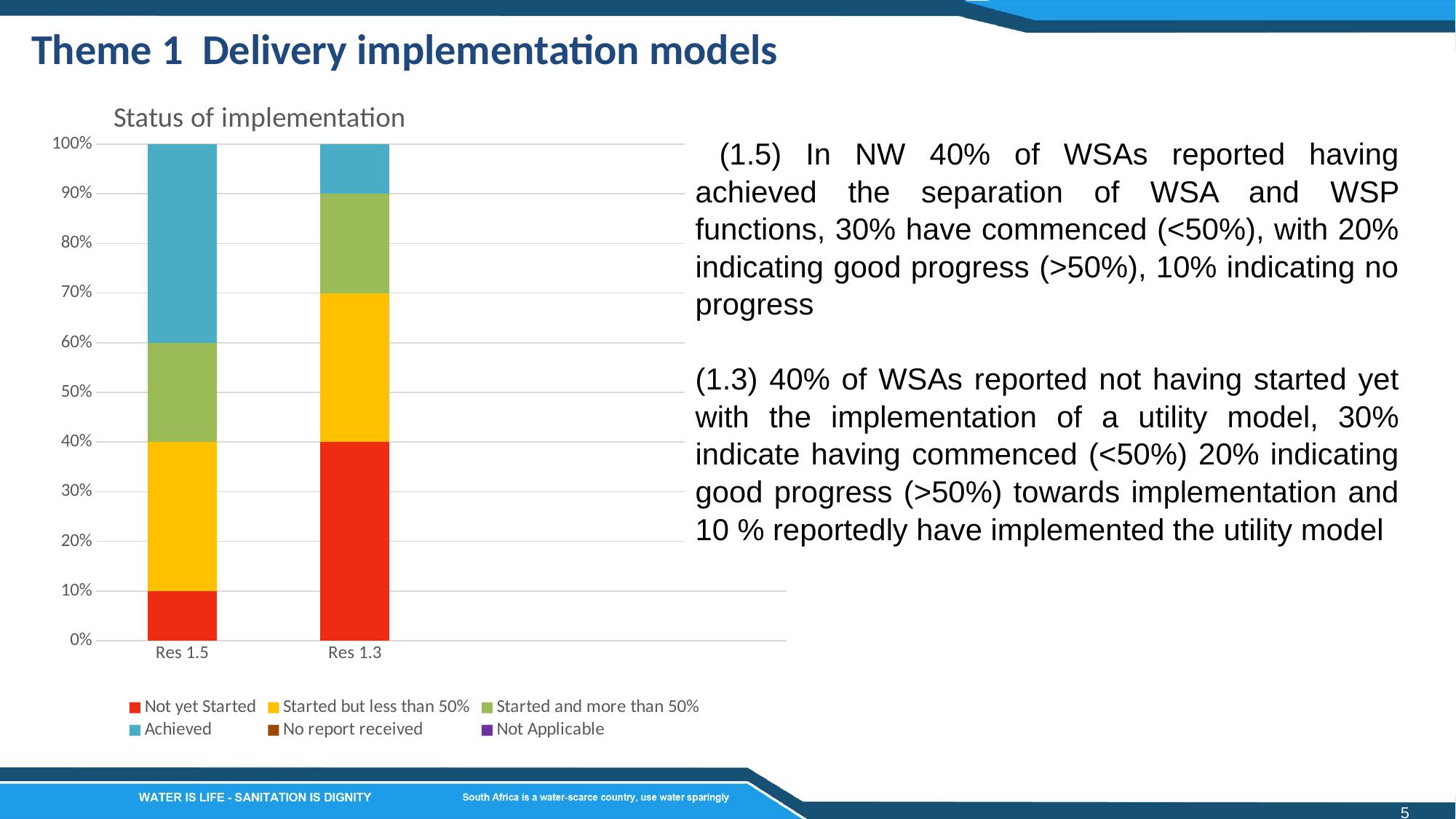
How many series does the chart's legend list? 6 What is the "Not yet Started" share for Res 1.5? 10% Is the "Achieved" share for Res 1.3 greater or less than 20%? less What is the "Not yet Started" share for Res 1.3? 40% What is the total height of the stacked bar for Res 1.5? 100% Which category has the larger "Achieved" segment, Res 1.5 or Res 1.3? Res 1.5 Which category has the larger "Not yet Started" segment, Res 1.5 or Res 1.3? Res 1.3 Which colour represents the "Achieved" series in the chart? Blue What is the title of the chart? Status of implementation How many categories are plotted on the x axis of the chart? 2 What kind of chart is shown under the title "Status of implementation"? Stacked bar chart Is the "Achieved" share for Res 1.5 greater or less than 30%? greater